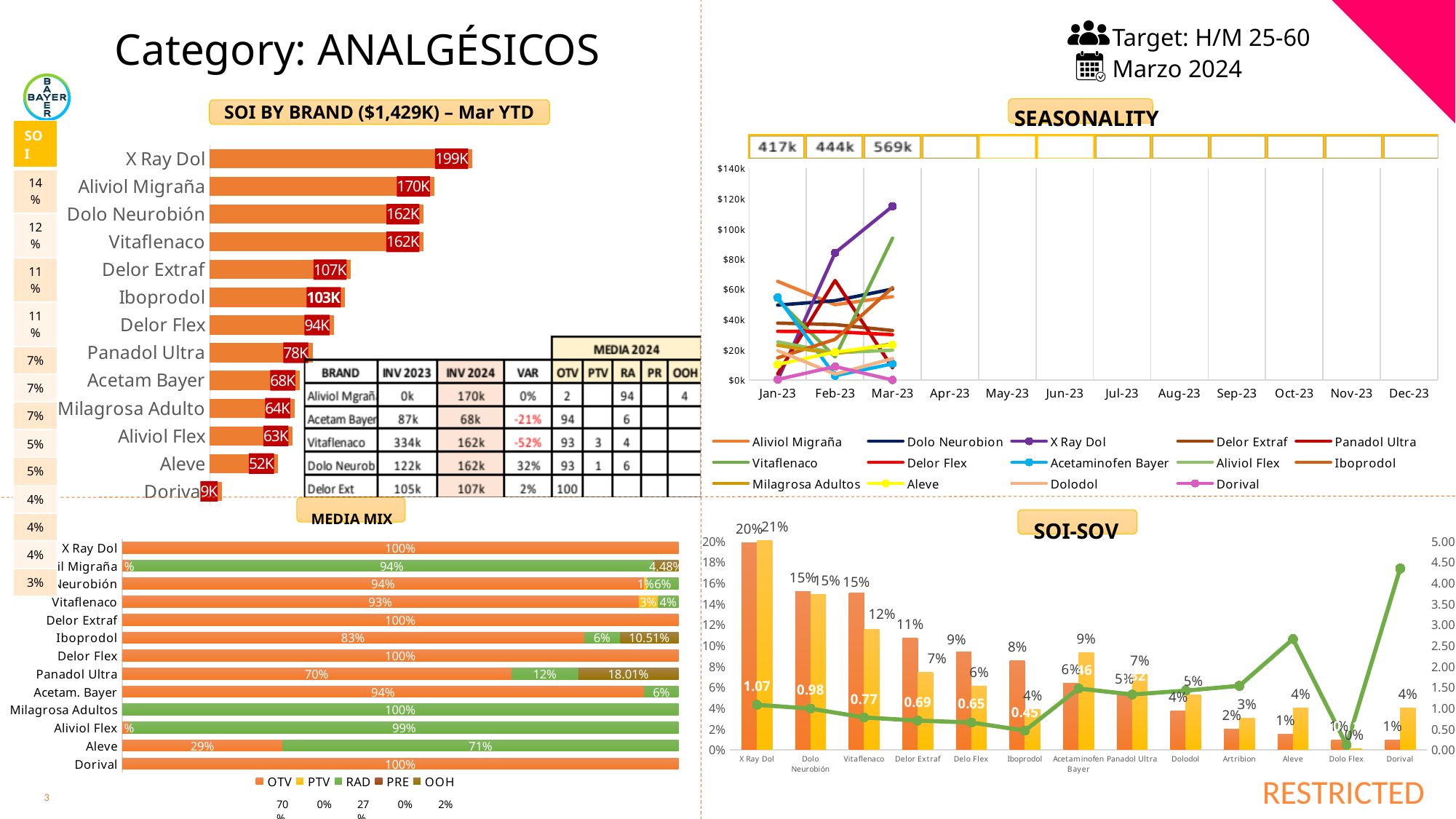
In the SOI BY BRAND chart, what is the difference between X Ray Dol and Aliviol Migraña? 29K In the SEASONALITY chart, how many series does the legend list? 14 In the SOI BY BRAND chart, which brand has the lowest value? Dorival In the SOI-SOV chart, what is the line value for X Ray Dol? 1.07 In the MEDIA MIX chart, what is the OTV share for Aleve? 29% In the SOI BY BRAND chart, what is the value for Aleve? 52K In the SOI BY BRAND chart, which is larger, Delor Extraf or Panadol Ultra? Delor Extraf In the SOI BY BRAND chart, how many brands are shown? 13 In the SEASONALITY chart, is the value for X Ray Dol in Mar-23 greater or less than $100k? greater What kind of chart is the SEASONALITY chart? Line chart In the SOI BY BRAND chart, what is the value for X Ray Dol? 199K In the MEDIA MIX chart, how many series does the legend list? 5